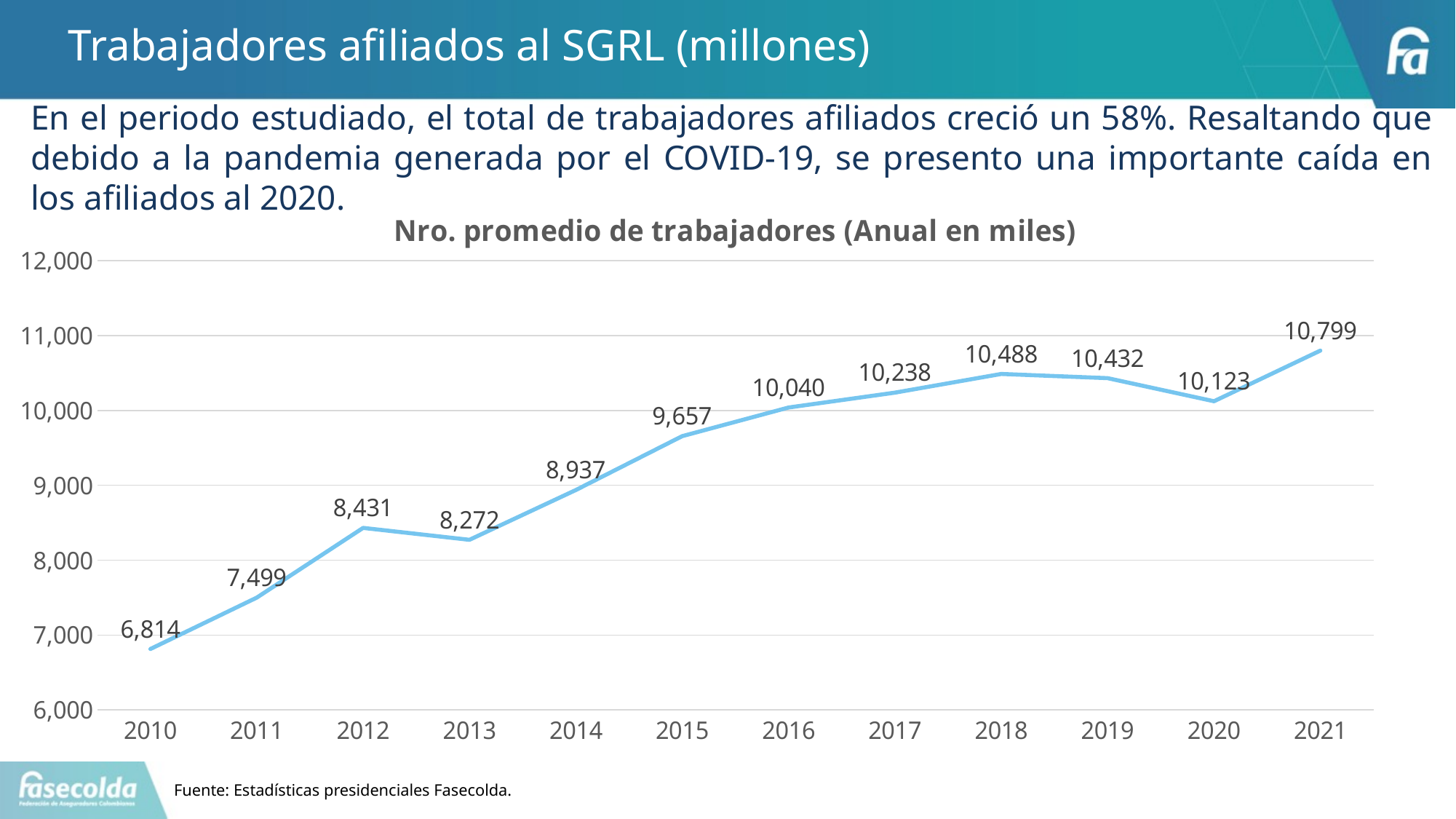
Is the value for 2016 greater or less than 10,000? greater Which year has the highest value? 2021 How many years are plotted on the chart? 12 What is the value for 2020? 10,123 What is the value for 2010? 6,814 What is the difference between the values for 2019 and 2020? 309 What is the value for 2015? 9,657 What is the title of the chart? Nro. promedio de trabajadores (Anual en miles) What is the difference between the values for 2021 and 2010? 3,985 Which is larger, the value for 2012 or the value for 2013? 2012 Which year has the lowest value? 2010 What kind of chart is shown? Line chart